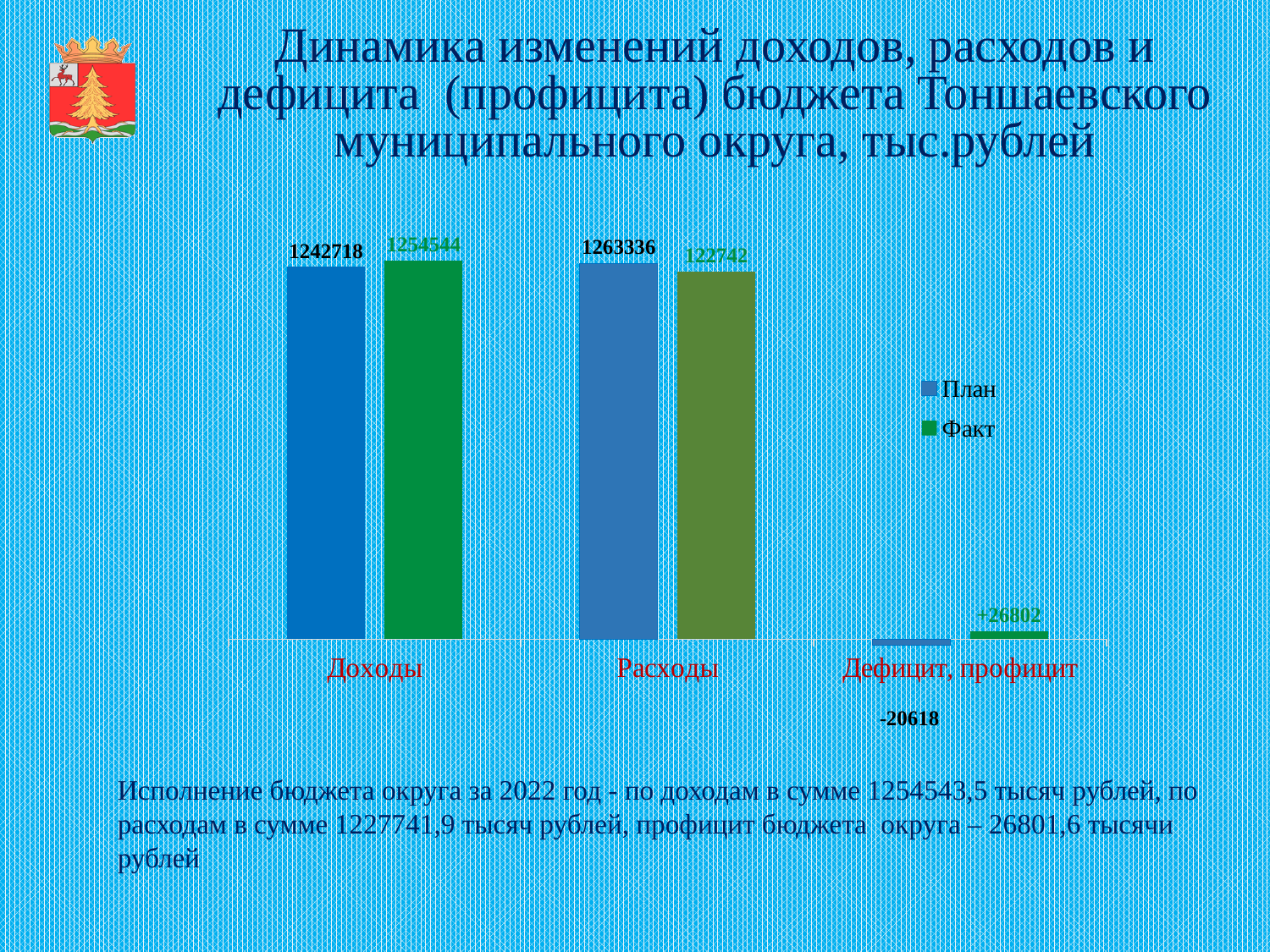
What is the План value for Дефицит, профицит? -20618 What is the Факт value for Дефицит, профицит? +26802 What is the Факт value for Расходы? 1227742 What is the План value for Доходы? 1242718 What is the difference between the План and Факт values for Расходы? 35594 Is the Факт value for Доходы larger or smaller than the План value for Доходы? larger How many series does the legend list? 2 What is the Факт value for Доходы? 1254544 What kind of chart is shown on the slide? bar chart What is the План value for Расходы? 1263336 Which category has the lowest Факт value? Дефицит, профицит Which category has the highest План value? Расходы